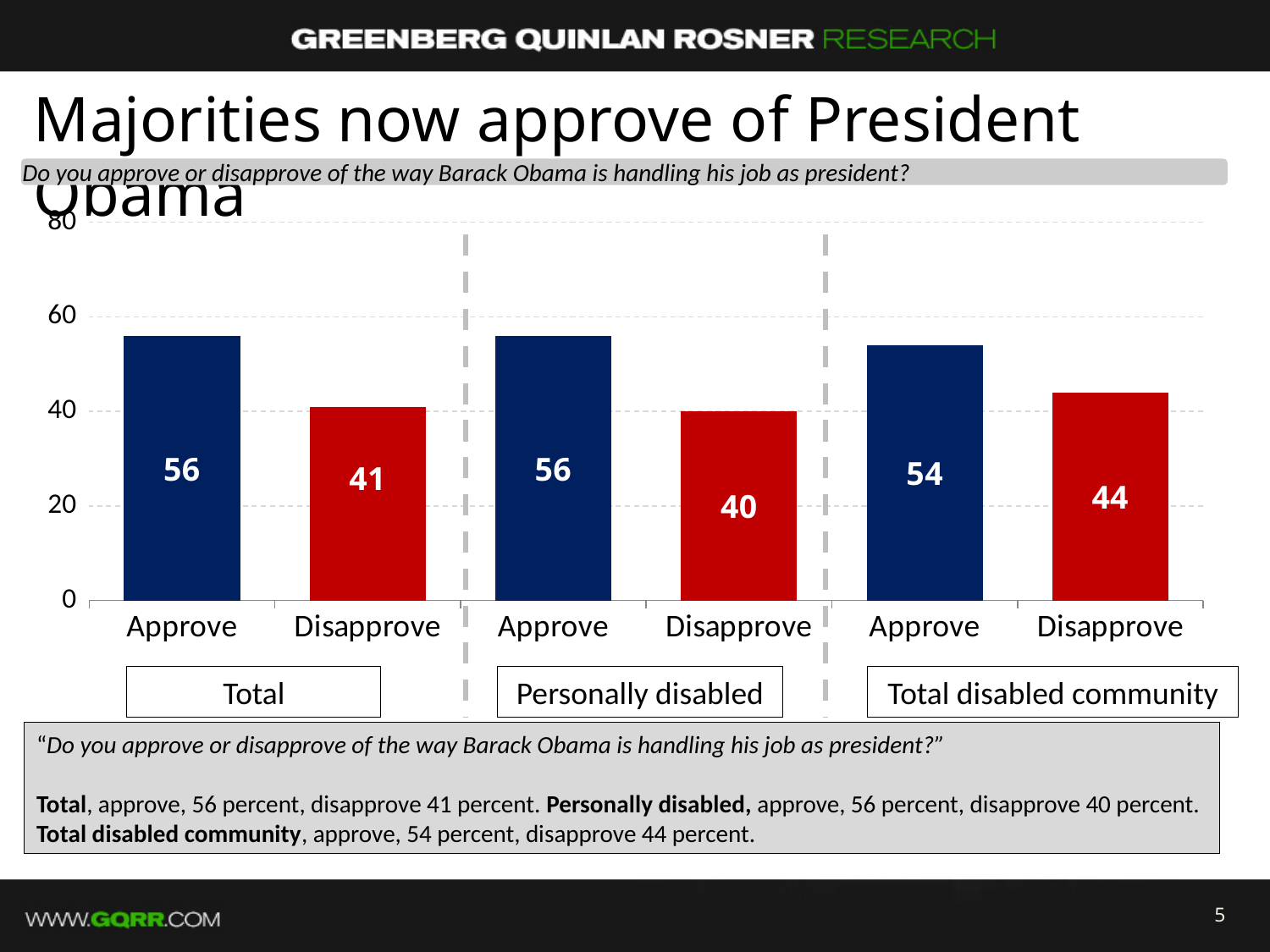
What is the difference between Approve and Disapprove for the Total group? 15 Which is larger: Disapprove for Total or Disapprove for Total disabled community? Disapprove for Total disabled community What is the Disapprove value for the Personally disabled group? 40 What is the difference between Approve and Disapprove for the Total disabled community group? 10 How many bars are plotted on the chart? 6 What kind of chart is shown on the slide? bar chart Which bar has the lowest value on the chart? Disapprove, Personally disabled What is the Approve value for the Total disabled community group? 54 What is the Approve value for the Total group? 56 What is the Disapprove value for the Total disabled community group? 44 Is the Approve value for the Personally disabled group greater or less than 40? greater What colour are the Approve bars? dark blue